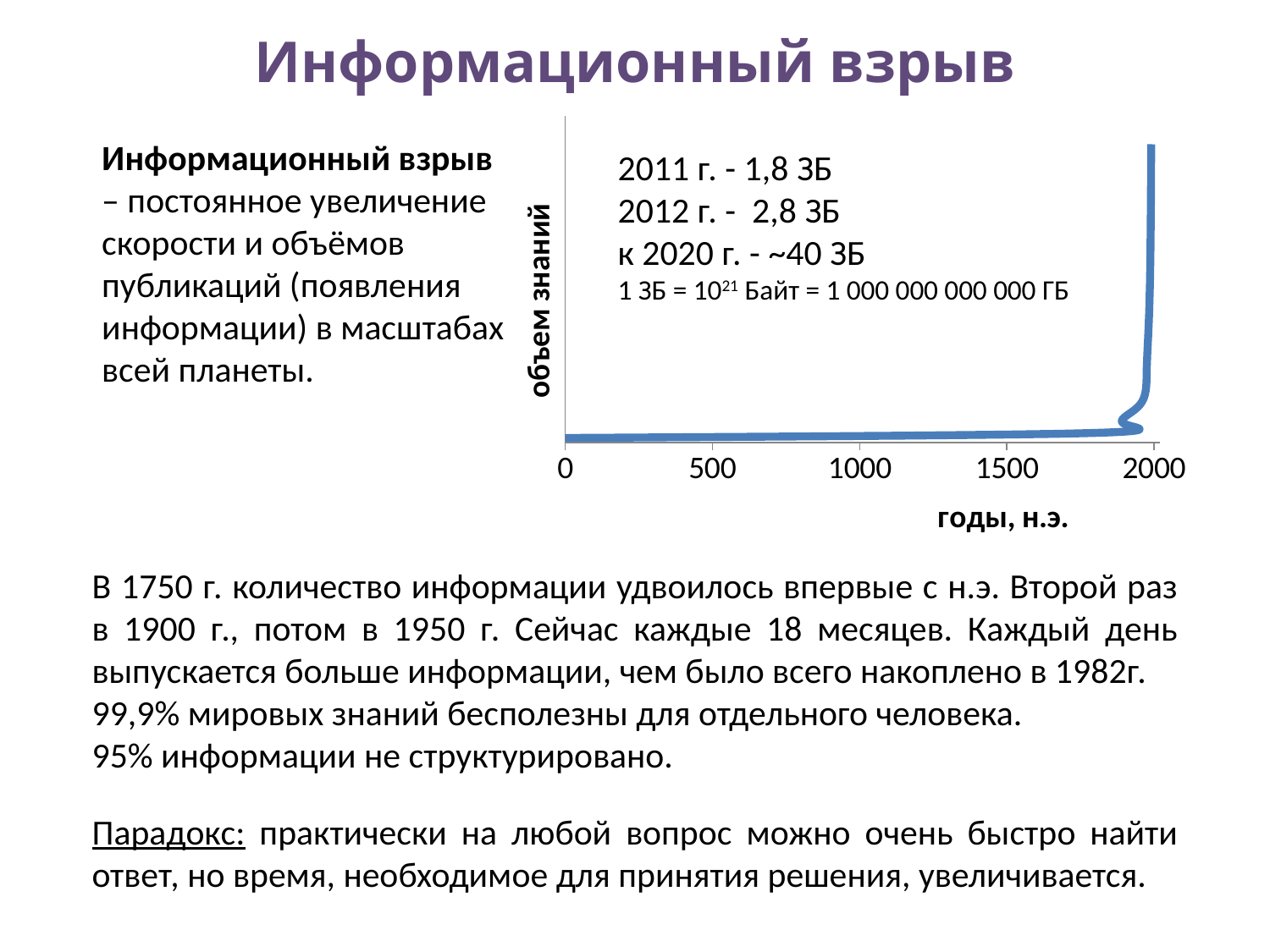
What kind of chart is shown on the slide? line chart Is the plotted line nearly flat or steeply rising between the years 0 and 1500? nearly flat What is the largest value shown on the x axis of the chart? 2000 What is the label of the x axis of the chart? годы, н.э. According to the text printed on the chart, what volume of knowledge is given for 2012? 2,8 ЗБ How many tick labels are shown on the x axis of the chart? 5 According to the text printed on the chart, what volume of knowledge is expected by 2020? ~40 ЗБ What is the label of the y axis of the chart? объем знаний Which year has the larger volume of knowledge according to the text on the chart, 2011 or 2012? 2012 According to the text printed on the chart, what volume of knowledge is given for 2011? 1,8 ЗБ Does the plotted line rise or fall as the years approach 2000? rises